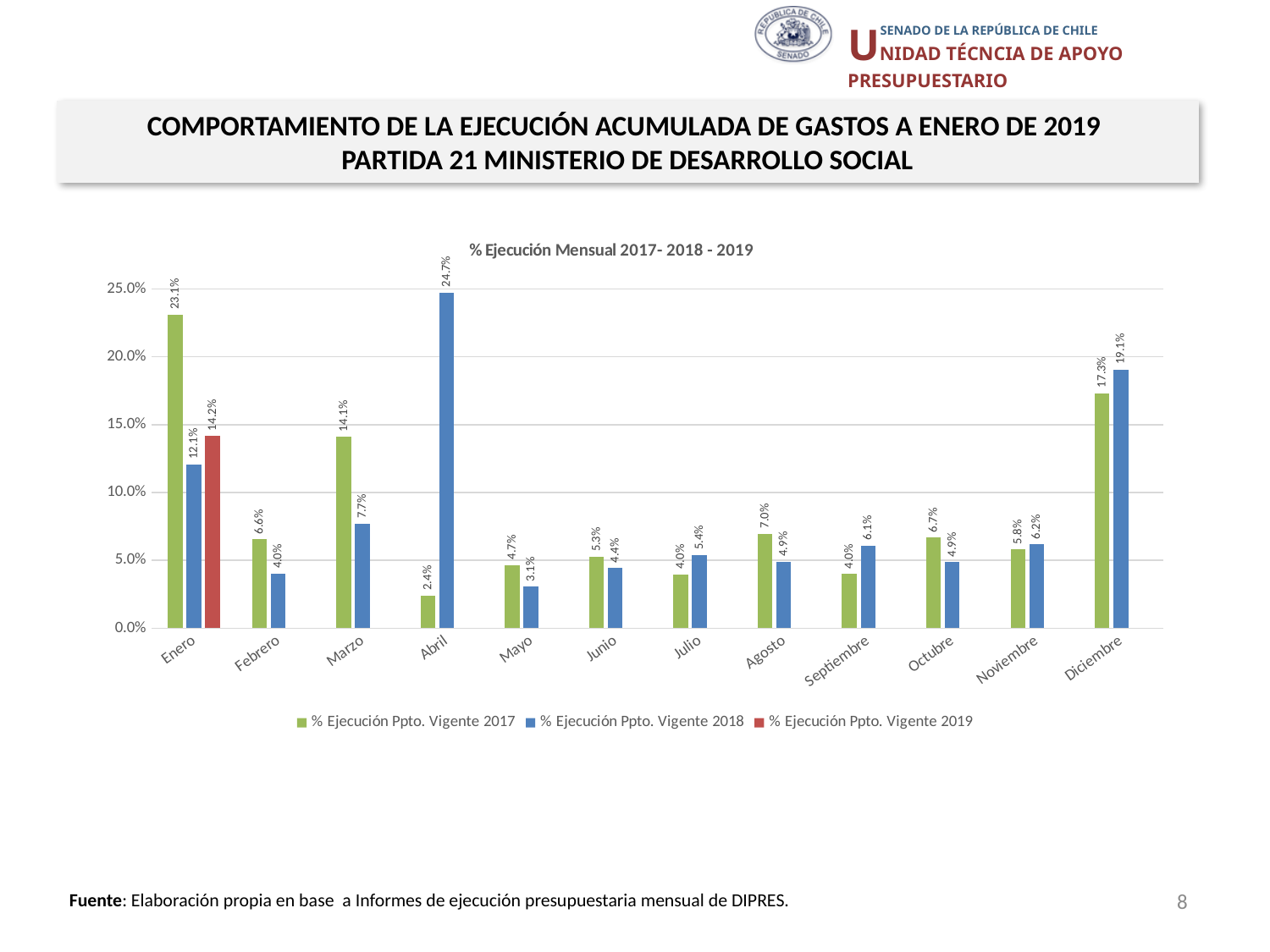
What is the value for % Ejecución Ppto. Vigente 2018 in Abril? 24.7% Which month has the lowest value for % Ejecución Ppto. Vigente 2017? Abril How many series does the legend list? 3 Which month has the highest value for % Ejecución Ppto. Vigente 2018? Abril What is the value for % Ejecución Ppto. Vigente 2019 in Enero? 14.2% What is the value for % Ejecución Ppto. Vigente 2017 in Enero? 23.1% What is the title of the chart? % Ejecución Mensual 2017- 2018 - 2019 In Marzo, which is larger: the 2017 value or the 2018 value? 2017 Is the value for % Ejecución Ppto. Vigente 2017 in Enero greater or less than 20.0%? greater What kind of chart is shown on the slide? bar chart What is the difference between the 2018 and 2017 values in Diciembre? 1.8% How many months are shown on the x axis? 12